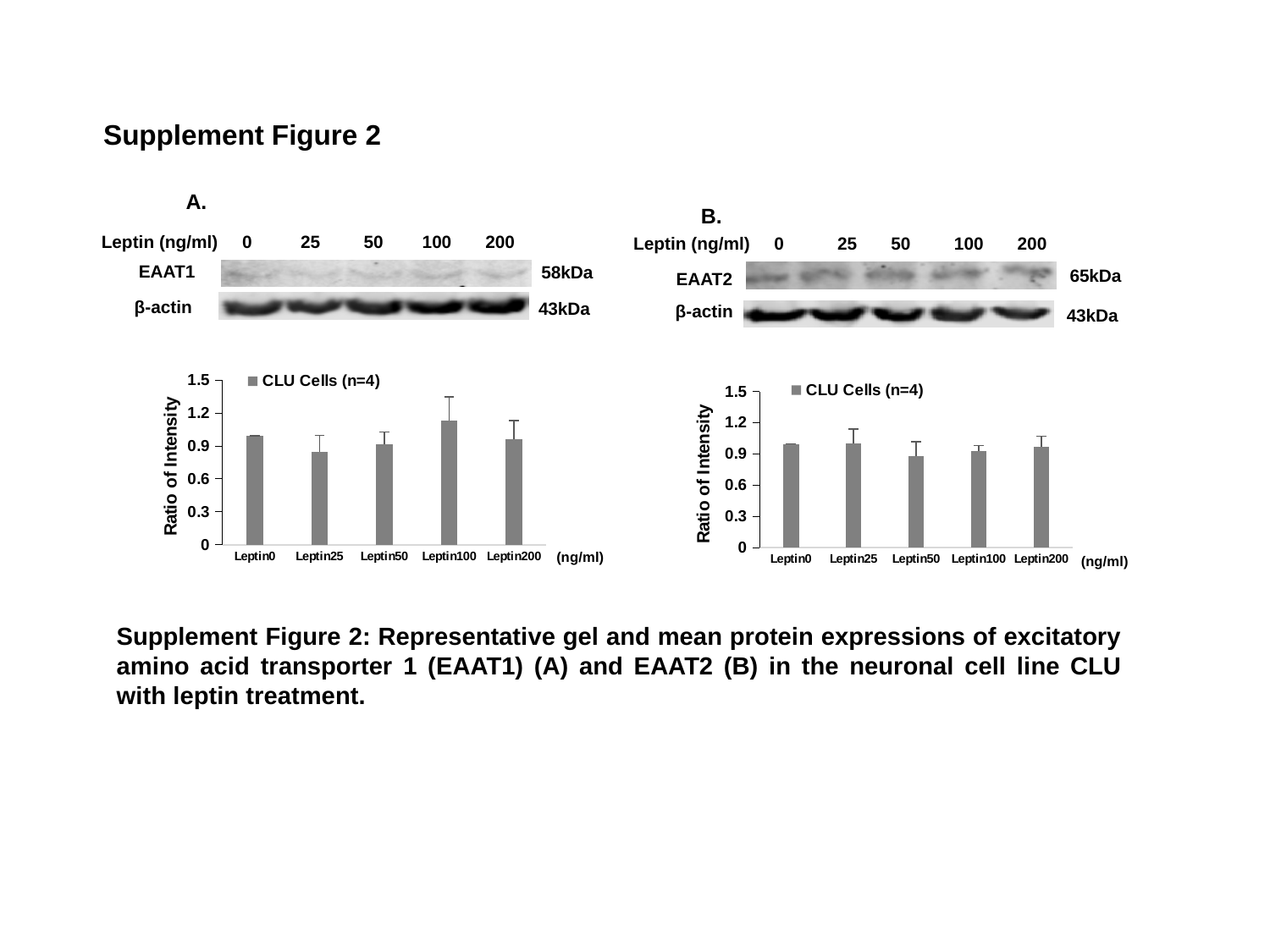
What is the legend entry shown in the chart in panel B (right)? CLU Cells (n=4) How many series does the legend of the chart in panel A (left) list? 1 In the chart in panel A (left), which category has the highest bar? Leptin100 In the chart in panel A (left), which is larger, the value for Leptin100 or the value for Leptin25? Leptin100 In the chart in panel A (left), is the value for Leptin25 greater or less than 0.9? less What is the y-axis title of the chart in panel A (left)? Ratio of Intensity In the chart in panel B (right), which category has the lowest bar? Leptin50 What kind of chart is the chart in panel A (left)? bar chart In the chart in panel A (left), is the value for Leptin100 greater or less than 0.9? greater How many categories are plotted on the x axis of the chart in panel B (right)? 5 In the chart in panel A (left), which category has the lowest bar? Leptin25